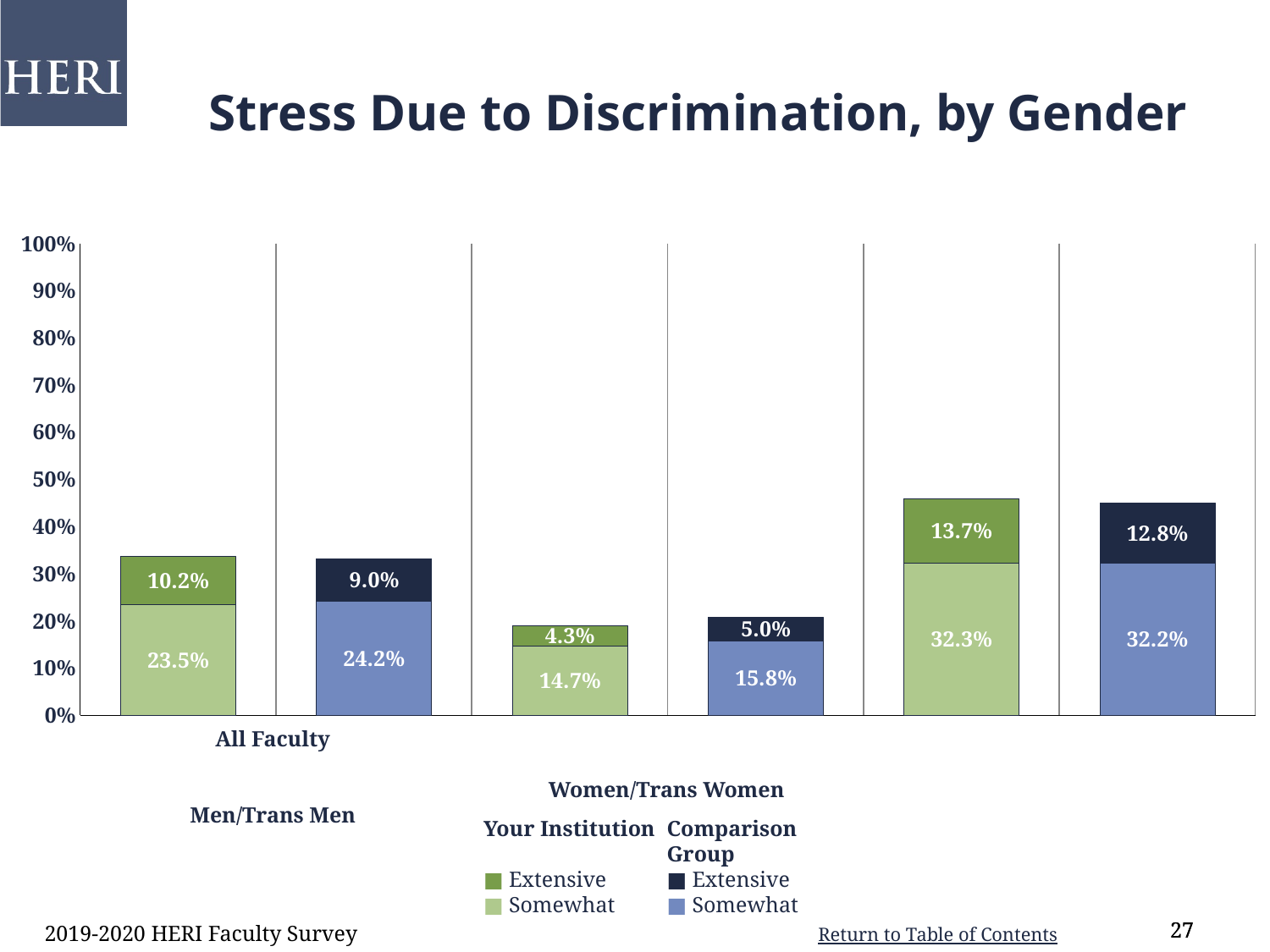
What percentage of Women/Trans Women at Your Institution reported "Somewhat" stress due to discrimination? 32.3% Is the total of the Your Institution bar for Men/Trans Men greater or less than 20%? less What is the "Extensive" value for All Faculty at Your Institution? 10.2% What is the total height of the Your Institution stacked bar for Women/Trans Women? 46.0% Which gender group has the highest "Extensive" value for Your Institution? Women/Trans Women What type of chart is shown on the slide? Stacked bar chart What is the difference between the "Somewhat" values for Men/Trans Men in the Comparison Group and at Your Institution? 1.1% What is the "Extensive" value for Men/Trans Men in the Comparison Group? 5.0% What is the total height of the Comparison Group stacked bar for All Faculty? 33.2% How many gender categories are shown on the x axis? 3 Which is larger: the "Extensive" value for Women/Trans Women at Your Institution or in the Comparison Group? Your Institution Which gender group has the lowest "Somewhat" value in the Comparison Group? Men/Trans Men